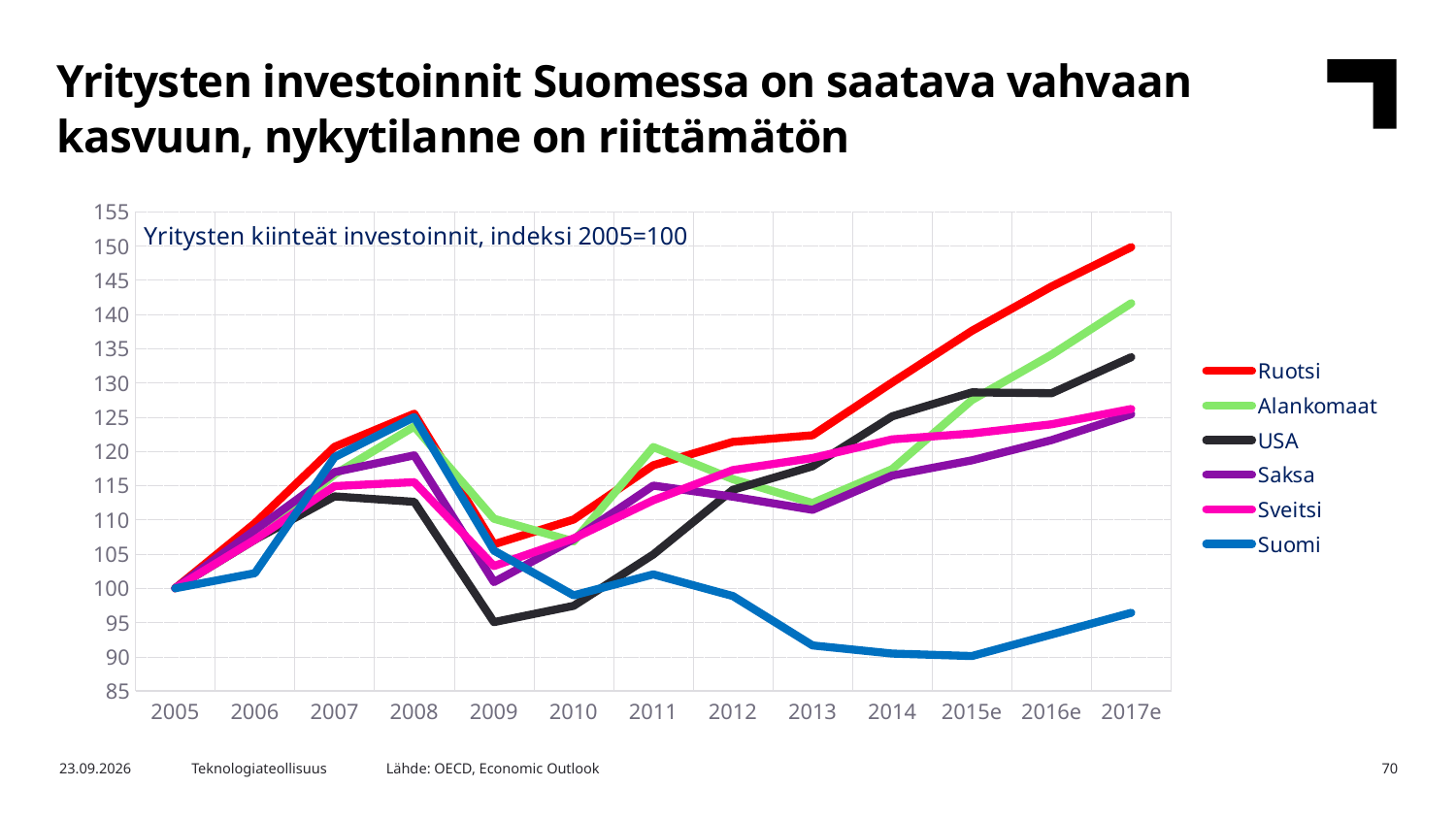
What kind of chart is shown on the slide? line chart Which series has the highest value in 2017e? Ruotsi How many series does the legend list? 6 How many years are shown along the x axis? 13 What is the index value for Ruotsi in 2005? 100 Which series has the lowest value in 2009? USA What is the subtitle printed inside the chart area? Yritysten kiinteät investoinnit, indeksi 2005=100 In 2017e, which is larger: Alankomaat or USA? Alankomaat Which series has the lowest value in 2017e? Suomi Is the value for Suomi in 2015e greater or less than 95? less Does the Suomi line rise or fall from 2012 to 2015e? fall Is the value for Ruotsi in 2017e greater or less than 145? greater